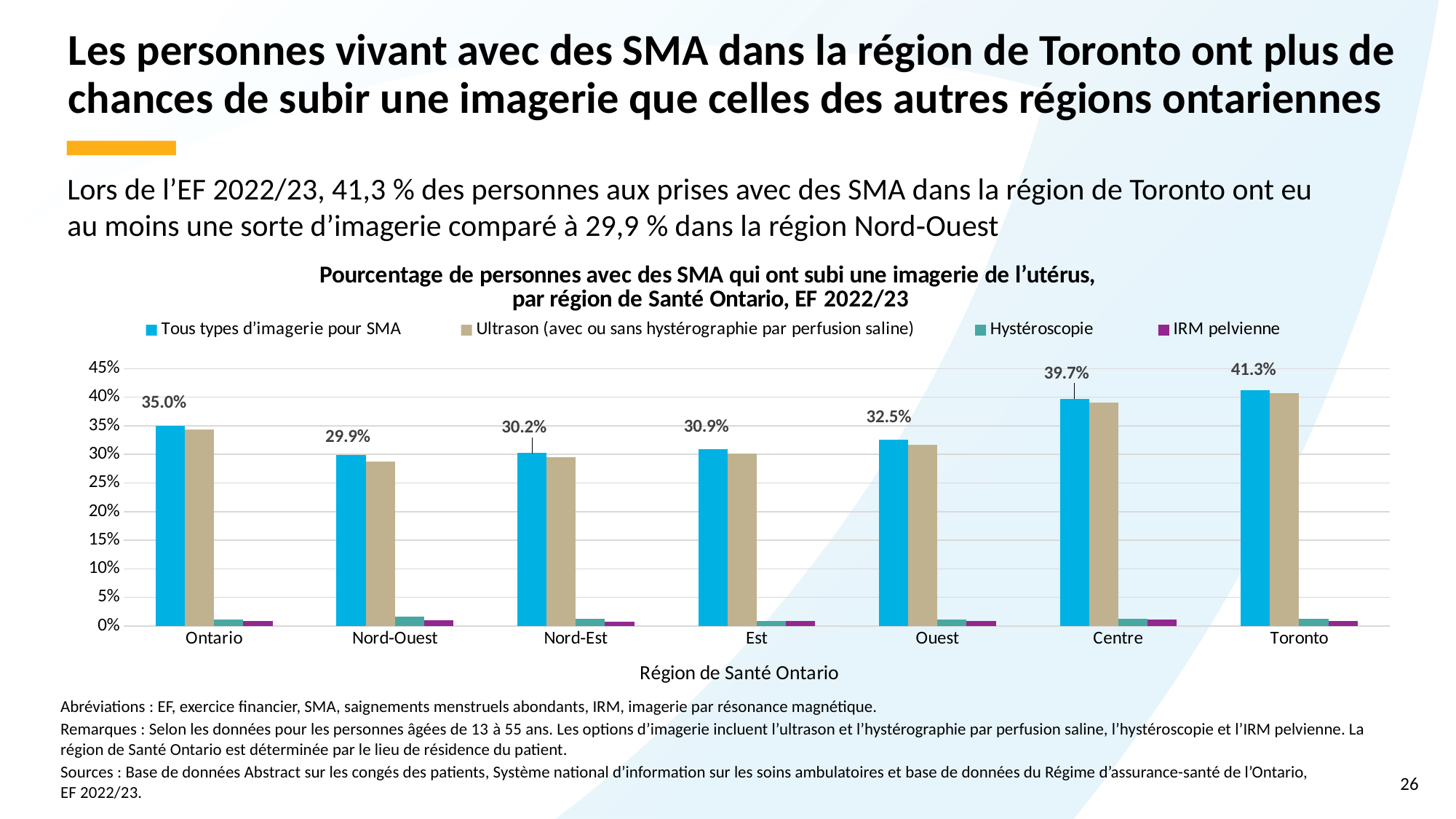
Which has a larger 'Tous types d'imagerie pour SMA' value, Centre or Ouest? Centre What type of chart is shown on the slide? bar chart How many regions are shown on the x axis of the chart? 7 What is the difference between the 'Tous types d'imagerie pour SMA' values for Toronto and Nord-Ouest? 11.4% Is the 'Ultrason' value for Toronto greater or less than 35%? greater Which series is shown in blue in the chart? Tous types d'imagerie pour SMA How many series does the chart legend list? 4 What is the value of 'Tous types d'imagerie pour SMA' for Ontario? 35.0% What is the value of 'Tous types d'imagerie pour SMA' for Nord-Ouest? 29.9% What is the value of 'Tous types d'imagerie pour SMA' for Toronto? 41.3% Which region has the highest value for 'Tous types d'imagerie pour SMA'? Toronto Which region has the lowest value for 'Tous types d'imagerie pour SMA'? Nord-Ouest